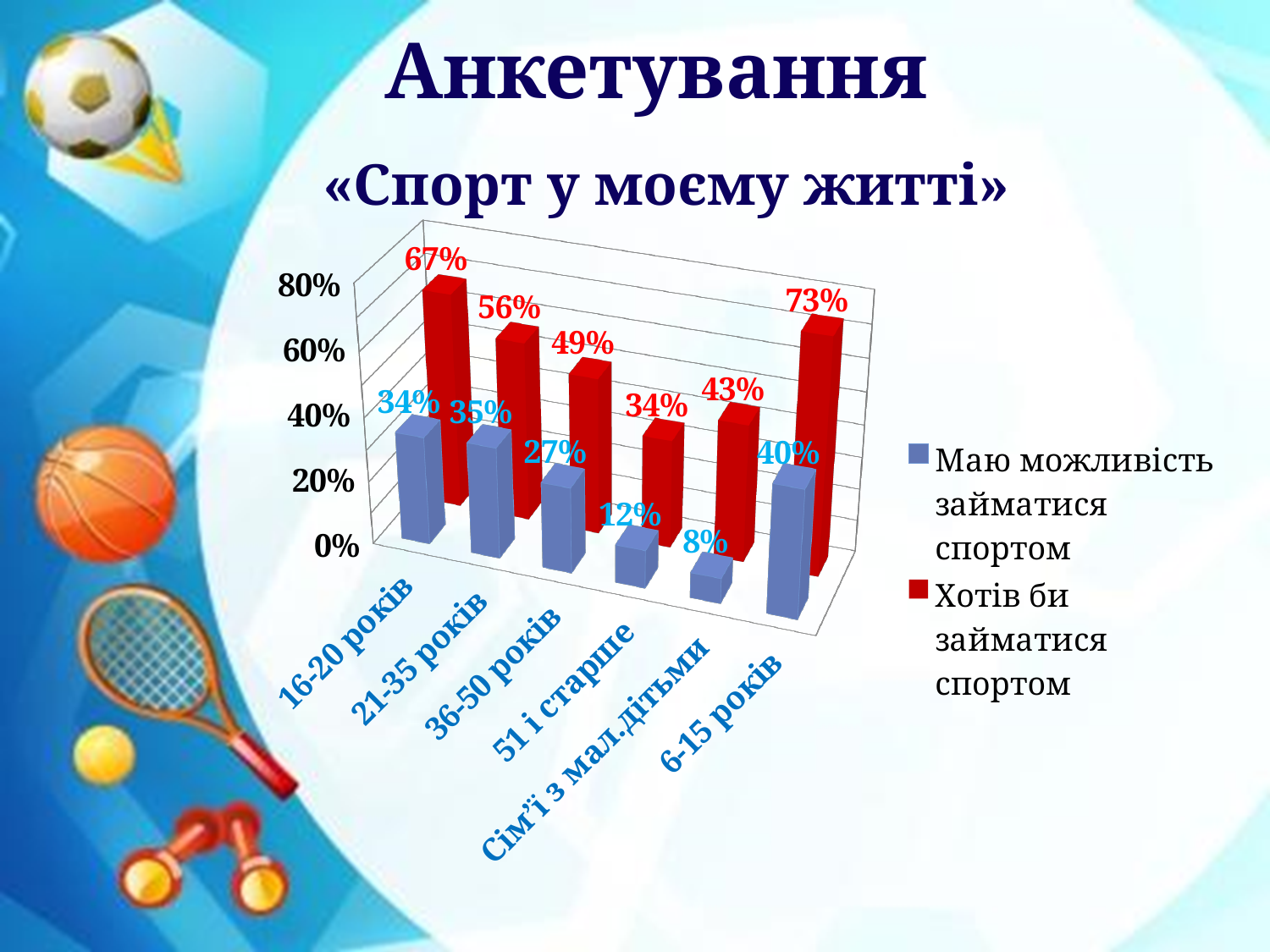
Which category has the highest value for Хотів би займатися спортом? 6-15 років What is the value for Сім'ї з мал.дітьми in the series Маю можливість займатися спортом? 8% Which colour represents the series Хотів би займатися спортом in the chart? Red Which is larger for 36-50 років: Маю можливість займатися спортом or Хотів би займатися спортом? Хотів би займатися спортом How many age categories are shown on the x axis of the chart? 6 What is the title of the survey shown above the chart? «Спорт у моєму житті» What percentage of the 16-20 років group has the opportunity to do sports (Маю можливість займатися спортом)? 34% What is the difference between the Хотів би займатися спортом and Маю можливість займатися спортом values for 51 і старше? 22% What percentage of the 6-15 років group would like to do sports (Хотів би займатися спортом)? 73% How many series does the chart legend list? 2 Which category has the lowest value for Маю можливість займатися спортом? Сім'ї з мал.дітьми What kind of chart is shown on the slide? Bar chart